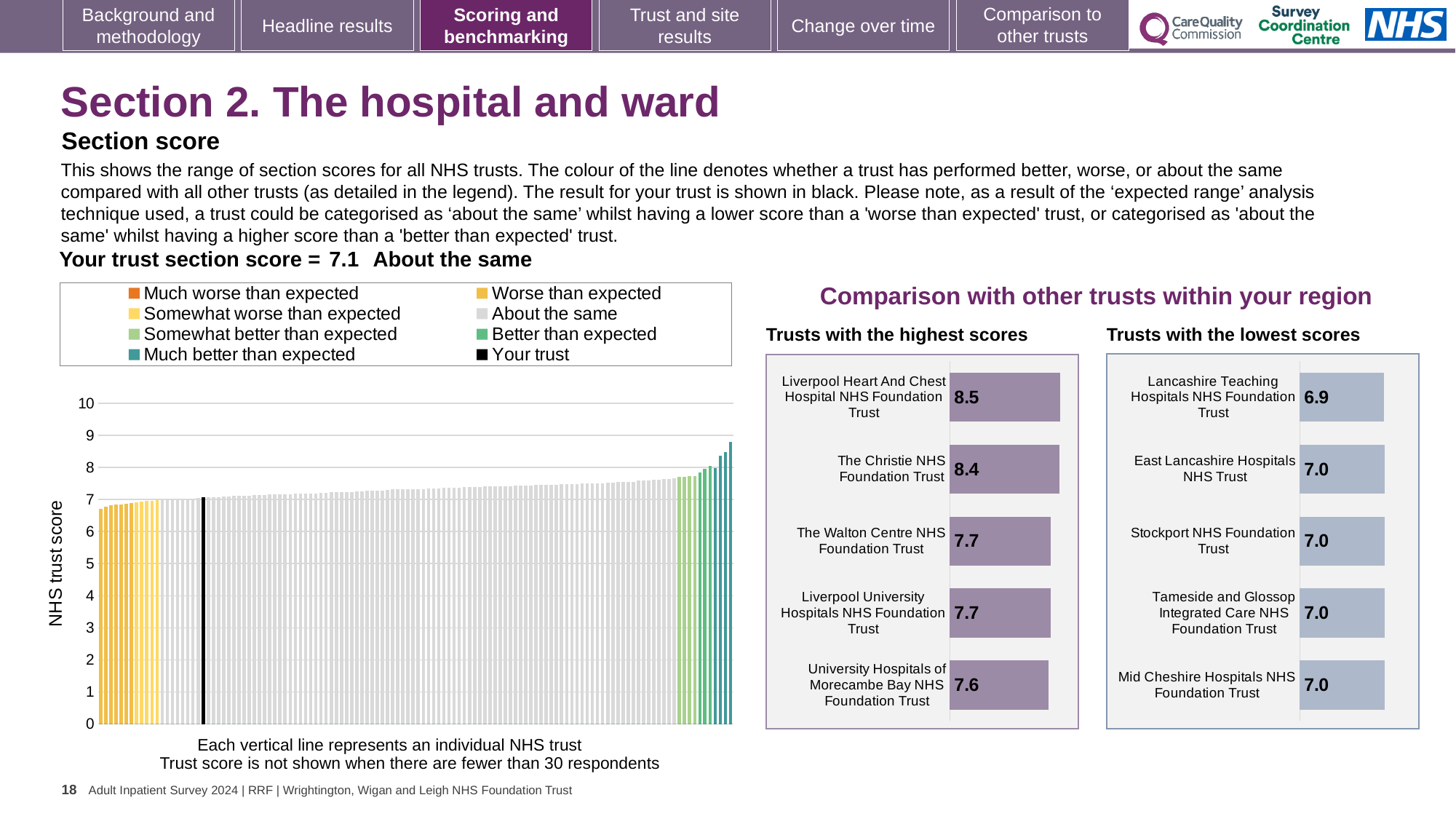
In the 'Trusts with the lowest scores' chart, what is the score for Stockport NHS Foundation Trust? 7.0 In the 'Trusts with the highest scores' chart, what is the score for Liverpool Heart And Chest Hospital NHS Foundation Trust? 8.5 How many trusts are shown in the 'Trusts with the highest scores' chart? 5 In the 'Trusts with the highest scores' chart, which trust has the highest score? Liverpool Heart And Chest Hospital NHS Foundation Trust In the 'Trusts with the lowest scores' chart, what is the score for Lancashire Teaching Hospitals NHS Foundation Trust? 6.9 In the 'Trusts with the highest scores' chart, what is the difference between the scores of Liverpool Heart And Chest Hospital NHS Foundation Trust and University Hospitals of Morecambe Bay NHS Foundation Trust? 0.9 In the 'Trusts with the highest scores' chart, which trust has the lowest score? University Hospitals of Morecambe Bay NHS Foundation Trust What kind of chart is the NHS trust score chart on the left of the slide? bar chart In the 'Trusts with the lowest scores' chart, which trust has the lowest score? Lancashire Teaching Hospitals NHS Foundation Trust How many trusts are shown in the 'Trusts with the lowest scores' chart? 5 How many entries does the legend of the NHS trust score chart on the left list? 8 In the NHS trust score chart on the left, do the trust scores rise or fall from left to right? rise